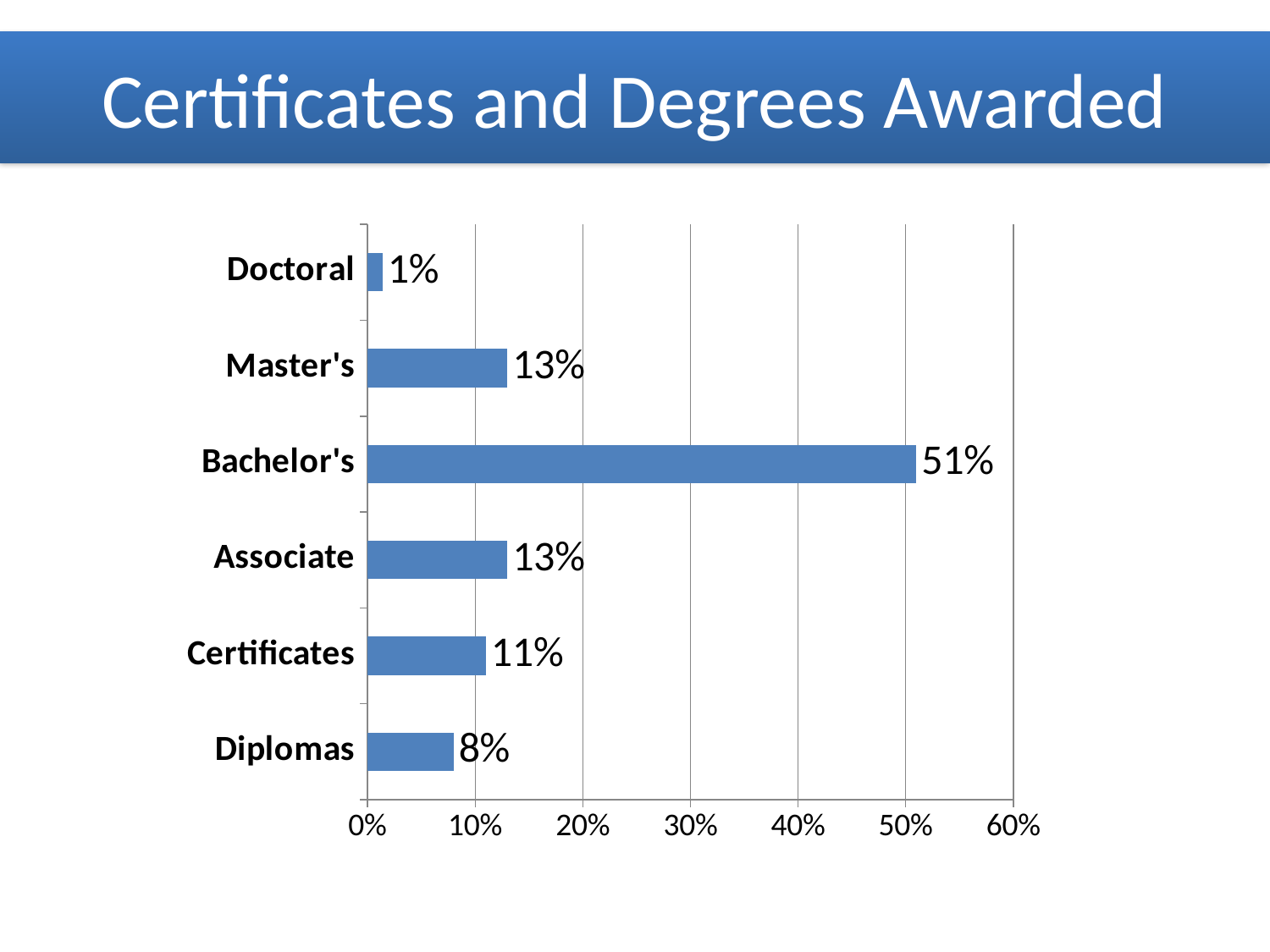
Is the value for Bachelor's greater or less than 40%? greater Which category has the lowest value? Doctoral What is the value shown for Diplomas? 8% What is the value shown for Doctoral? 1% What is the difference between the Certificates value and the Diplomas value? 3% Which is larger, the value for Certificates or the value for Diplomas? Certificates What percentage of certificates and degrees awarded were Bachelor's? 51% What is the value shown for Certificates? 11% What kind of chart is shown on the slide? Bar chart What is the difference between the Bachelor's value and the Master's value? 38% How many categories are shown in the chart? 6 Which category has the highest value? Bachelor's